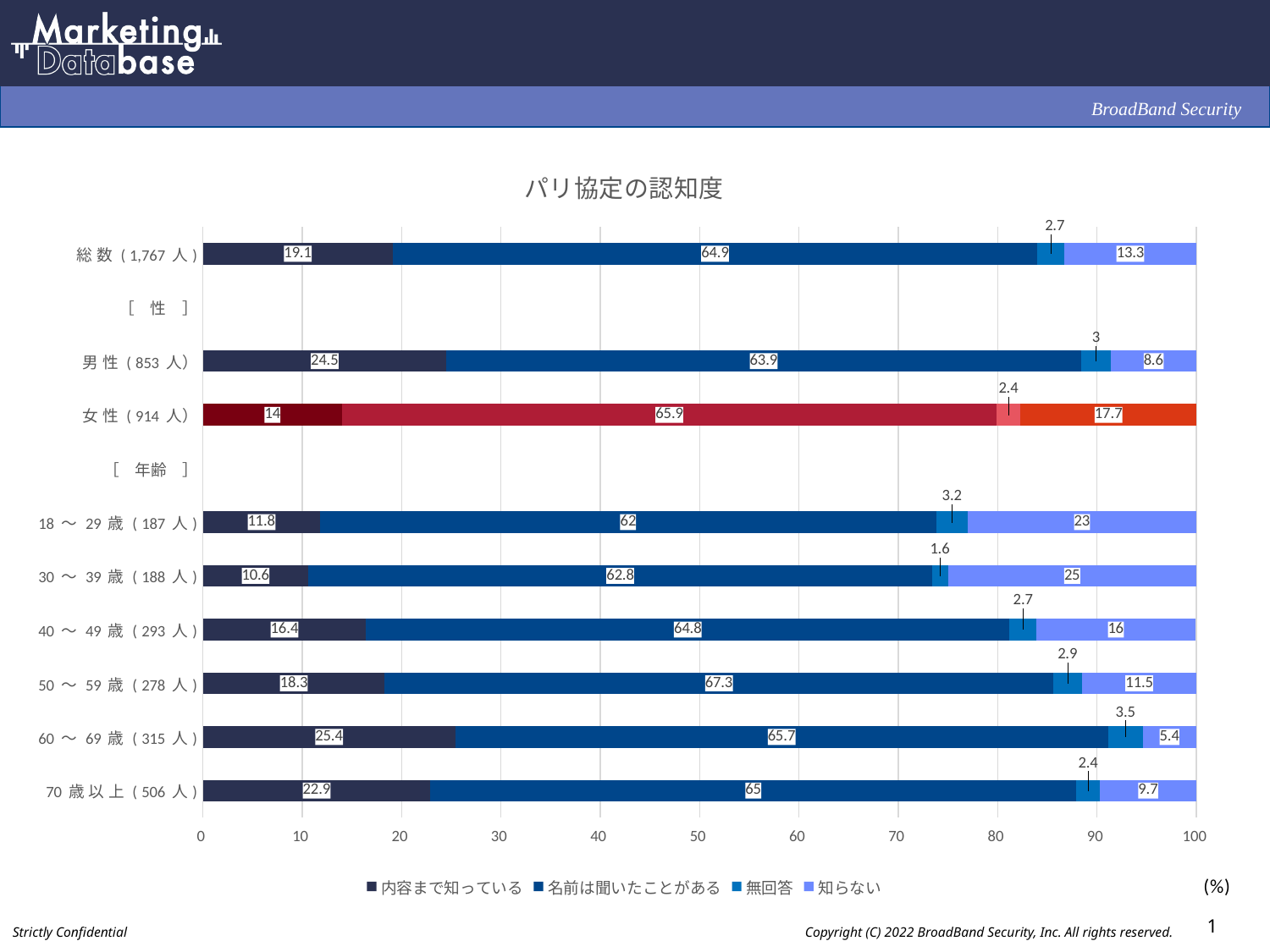
What is the value of 名前は聞いたことがある for 50～59歳 (278人)? 67.3 Which category has the lowest value for 知らない? 60～69歳 (315人) What is the total of the stacked bar for 40～49歳 (293人)? 99.9 What is the value of 知らない for 30～39歳 (188人)? 25 What is the title of the chart? パリ協定の認知度 Which is larger, the 知らない value for 18～29歳 (187人) or for 70歳以上 (506人)? 18～29歳 (187人) What is the difference between the 内容まで知っている values for 男性 (853人) and 女性 (914人)? 10.5 What is the value of 内容まで知っている for 総数 (1,767人)? 19.1 What is the value of 無回答 for 女性 (914人)? 2.4 Which category has the highest value for 内容まで知っている? 60～69歳 (315人) What kind of chart is shown on the slide? Stacked bar chart How many series does the legend list? 4